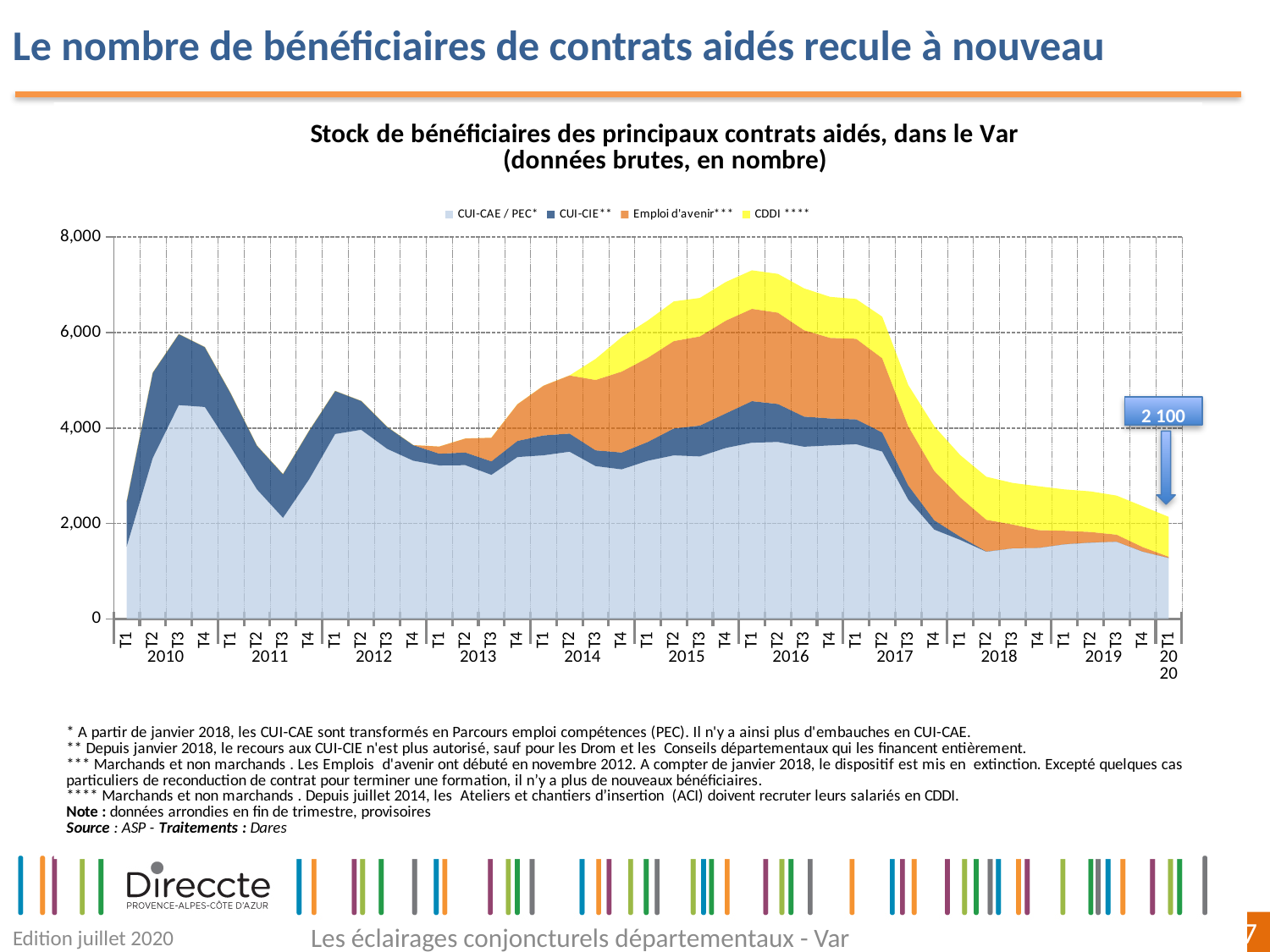
How many year labels appear on the x axis? 11 What is the title of the chart? Stock de bénéficiaires des principaux contrats aidés, dans le Var (données brutes, en nombre) What total value is labelled at T1 2020? 2 100 What kind of chart is shown on the slide? stacked area chart Which colour represents the CDDI series in the legend? yellow Does the total stock rise or fall between 2017 and T1 2020? fall Is the total stock at T1 2016 greater or less than 6,000? greater Is the total stock at T3 2010 greater or less than 4,000? greater In which quarter does the total stock reach its highest level? T1 2016 Which is larger, the total stock at T1 2016 or at T1 2020? T1 2016 Is the total stock at T1 2010 greater or less than 4,000? less How many series does the legend list? 4